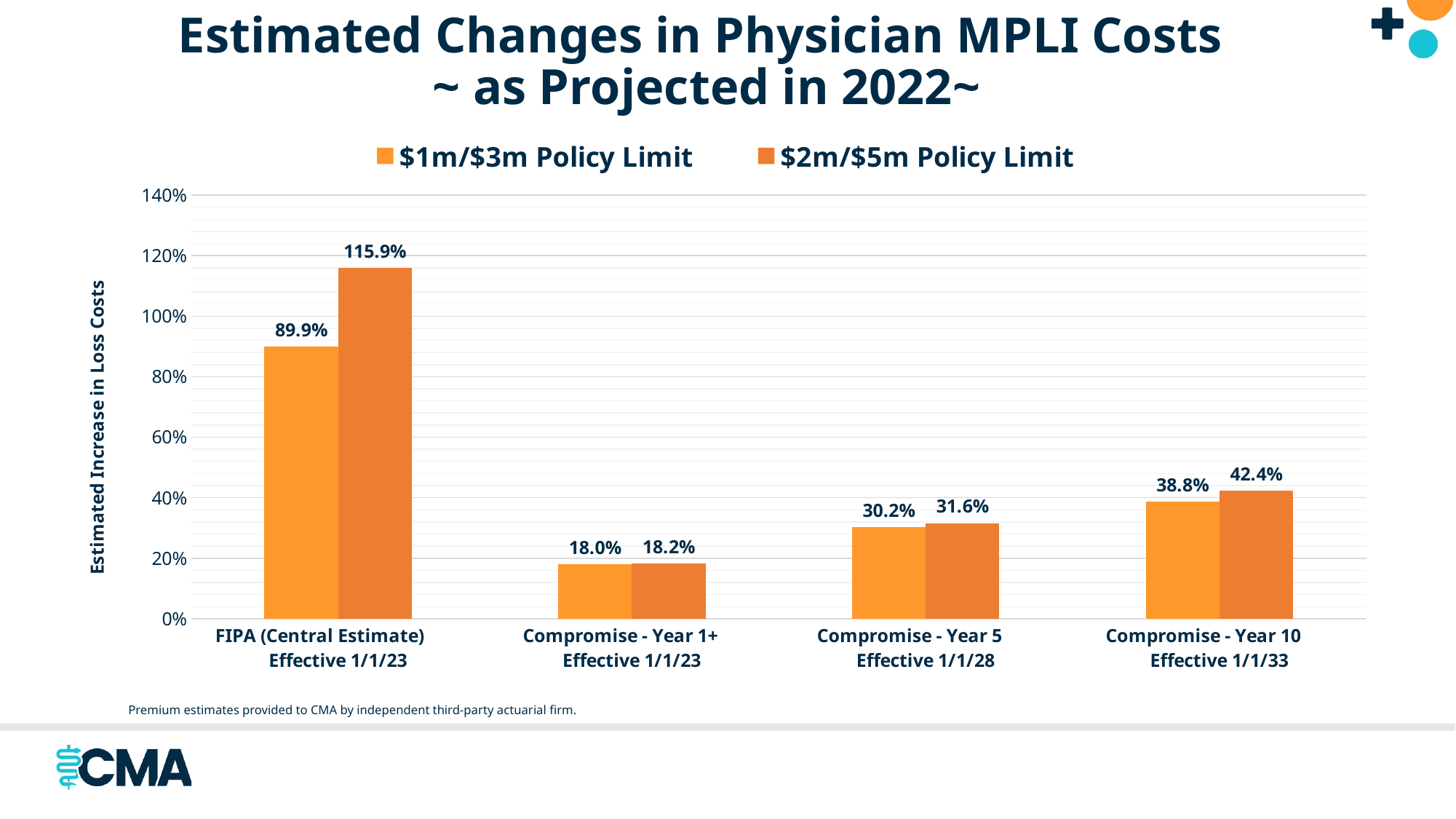
What is the label of the vertical axis? Estimated Increase in Loss Costs What is the value for the $2m/$5m Policy Limit series for Compromise - Year 10 Effective 1/1/33? 42.4% Which is larger for Compromise - Year 10 Effective 1/1/33: the $1m/$3m Policy Limit value or the $2m/$5m Policy Limit value? $2m/$5m Policy Limit What is the difference between the $2m/$5m and $1m/$3m Policy Limit values for FIPA (Central Estimate) Effective 1/1/23? 26.0% What is the value for the $1m/$3m Policy Limit series for Compromise - Year 5 Effective 1/1/28? 30.2% Is the $2m/$5m Policy Limit value for FIPA (Central Estimate) Effective 1/1/23 greater or less than 100%? greater What is the value for the $1m/$3m Policy Limit series for FIPA (Central Estimate) Effective 1/1/23? 89.9% How many series does the legend list? 2 Which category has the highest value for the $2m/$5m Policy Limit series? FIPA (Central Estimate) Effective 1/1/23 How many categories are shown on the x axis? 4 What kind of chart is shown on the slide? Bar chart Which category has the lowest value for the $1m/$3m Policy Limit series? Compromise - Year 1+ Effective 1/1/23